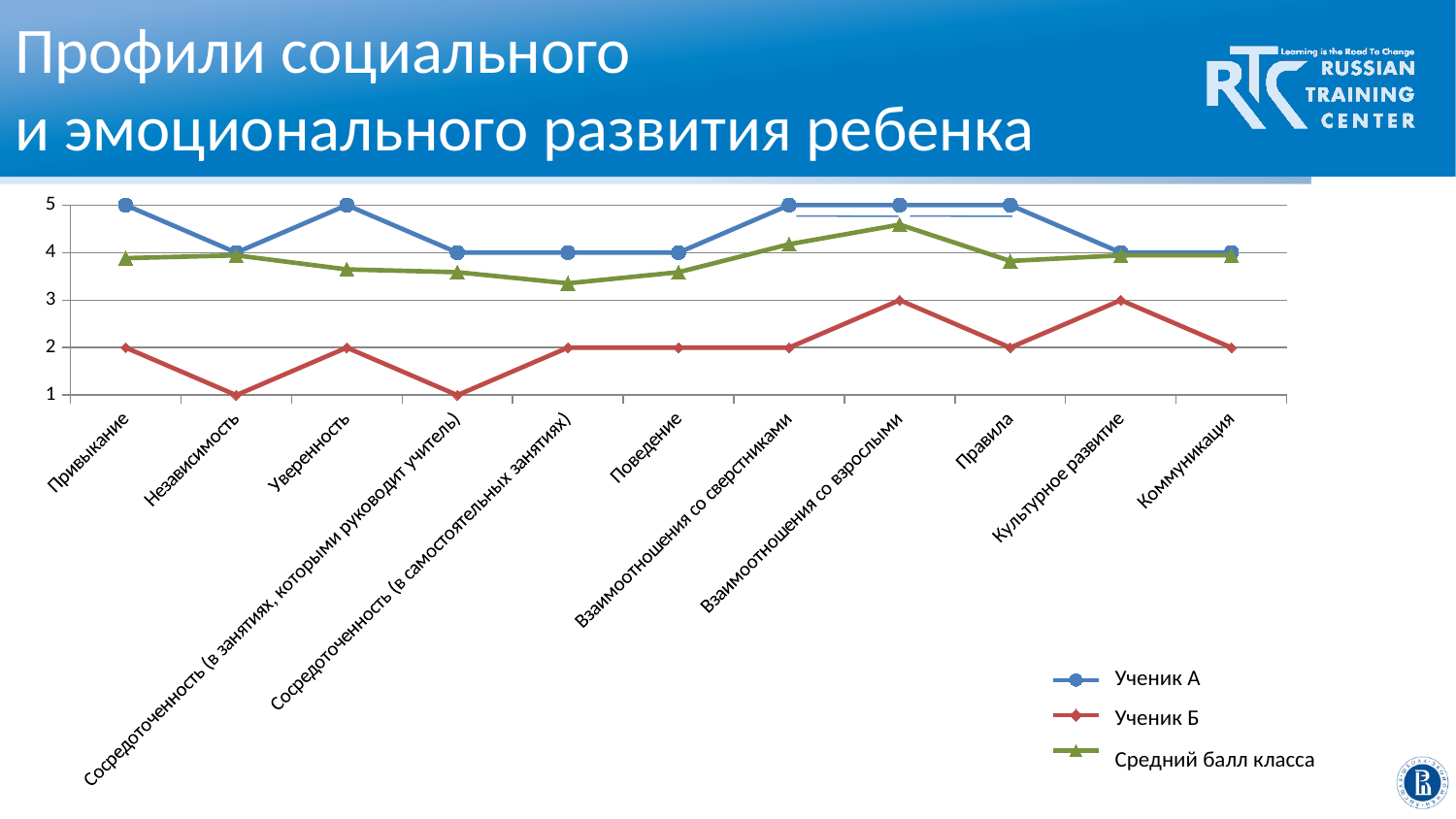
What colour is the line for Ученик Б? Red What is the value for Ученик Б in the category Независимость? 1 What is the value for Ученик А in the category Привыкание? 5 What is the difference between Ученик А and Ученик Б in the category Привыкание? 3 In which category does Средний балл класса reach its highest value? Взаимоотношения со взрослыми How many categories are plotted along the x axis? 11 Is the value for Средний балл класса in the category Сосредоточенность (в самостоятельных занятиях) greater or less than 4? less What kind of chart is shown on the slide? Line chart Is the value for Средний балл класса in the category Взаимоотношения со взрослыми greater or less than 4? greater How many series does the legend list? 3 What is the value for Ученик Б in the category Взаимоотношения со взрослыми? 3 In the category Поведение, which series has the larger value, Ученик А or Ученик Б? Ученик А